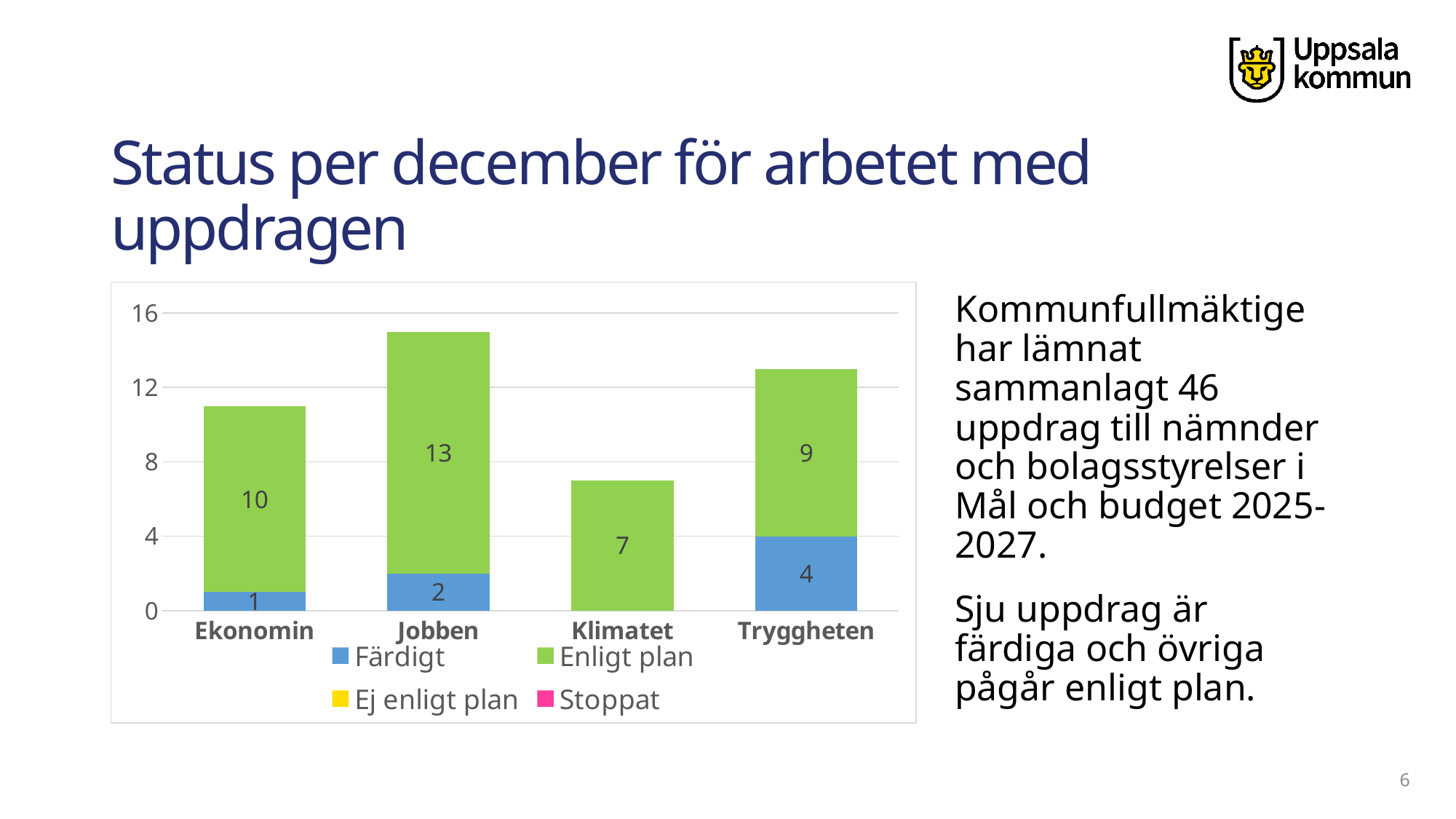
Which category has the lowest Enligt plan value? Klimatet What is the total of the stacked bar for Tryggheten? 13 Which is larger, the Färdigt value for Tryggheten or the Färdigt value for Jobben? Tryggheten How many categories are shown on the x axis? 4 What is the value of Enligt plan for Klimatet? 7 What is the value of Färdigt for Tryggheten? 4 How many series does the legend list? 4 What is the value of Enligt plan for Jobben? 13 What is the difference between the Enligt plan values for Jobben and Ekonomin? 3 What kind of chart is shown on the slide? Stacked bar chart Which category has the highest Enligt plan value? Jobben What is the total of the stacked bar for Ekonomin? 11